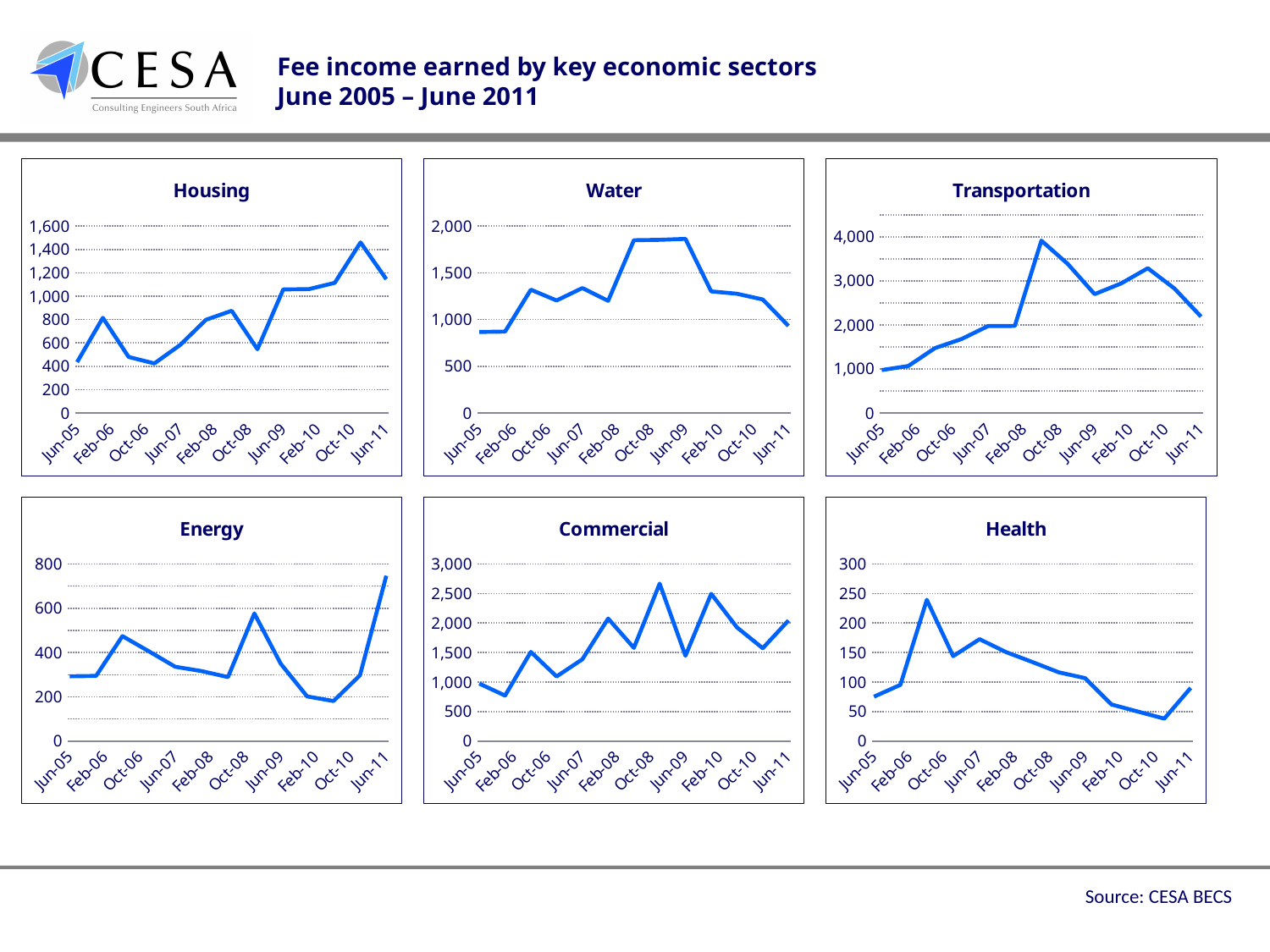
What kind of chart is used in the Housing panel? line chart In the Transportation chart, does the value at Jun-11 lie above or below the value at Jun-05? above Which of the six charts has the highest value on its vertical axis? Transportation In the Water chart, is the value at Jun-05 greater or less than 1,000? less In the Transportation chart, is the peak value greater or less than 3,000? greater In the Energy chart, is the value at Jun-11 greater or less than 600? greater In the Housing chart, does fee income overall rise or fall from Jun-05 to Jun-11? rise What is the source cited at the bottom of the slide? CESA BECS How many separate charts are shown on the slide? 6